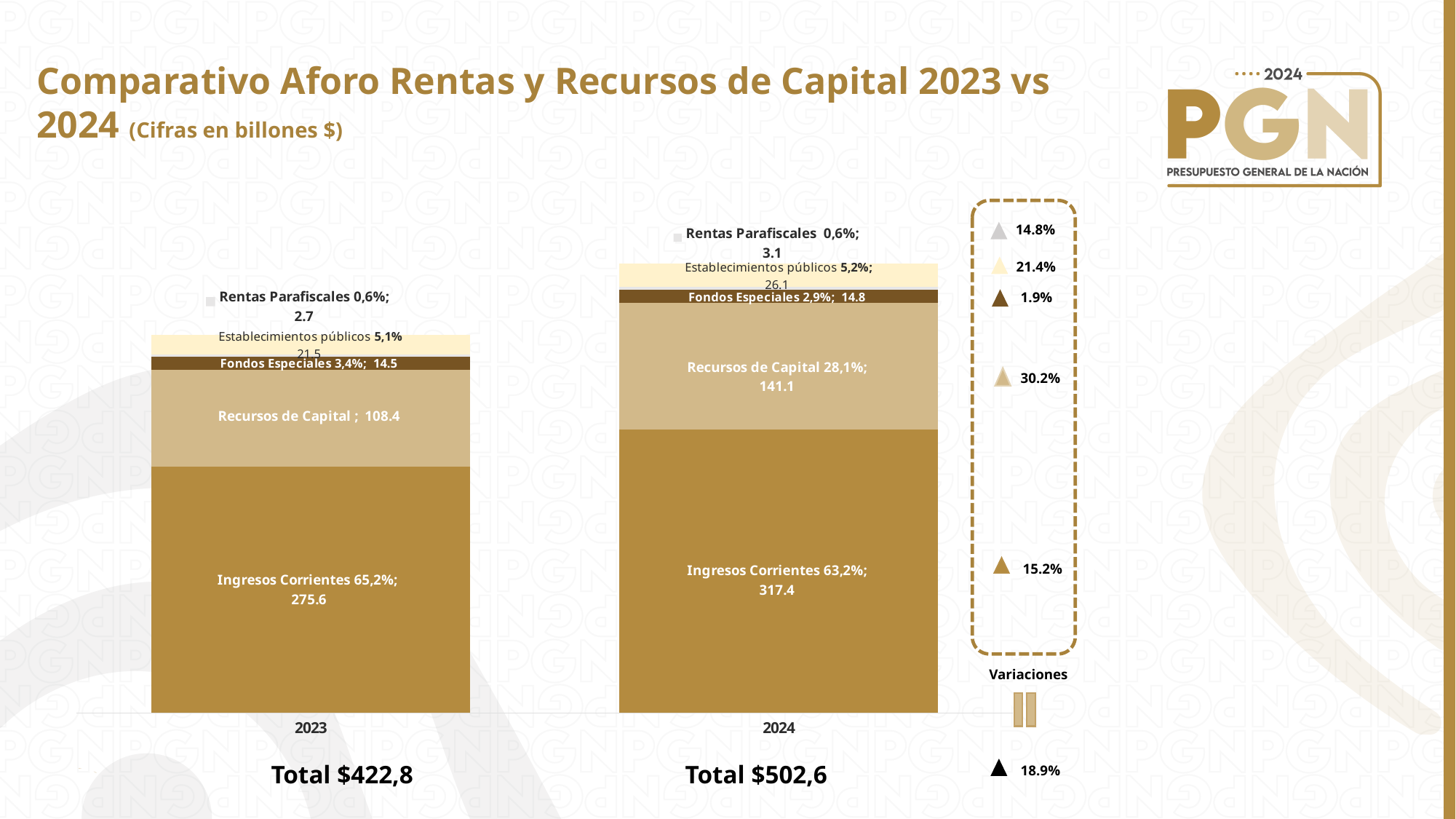
What is the value of Rentas Parafiscales for 2024? 3.1 What is the value of Recursos de Capital for 2024? 141.1 What type of chart is shown on the slide? Stacked bar chart What is the difference between Ingresos Corrientes in 2024 and 2023? 41.8 What is the total shown for the 2024 bar? Total $502,6 What is the value of Establecimientos públicos for 2023? 21.5 Which segment is the largest in the 2024 bar? Ingresos Corrientes Which segment is the smallest in the 2023 bar? Rentas Parafiscales What is the value of Ingresos Corrientes for 2023? 275.6 What is the total shown for the 2023 bar? Total $422,8 Is Recursos de Capital larger in 2023 or 2024? 2024 What is the value of Fondos Especiales for 2024? 14.8